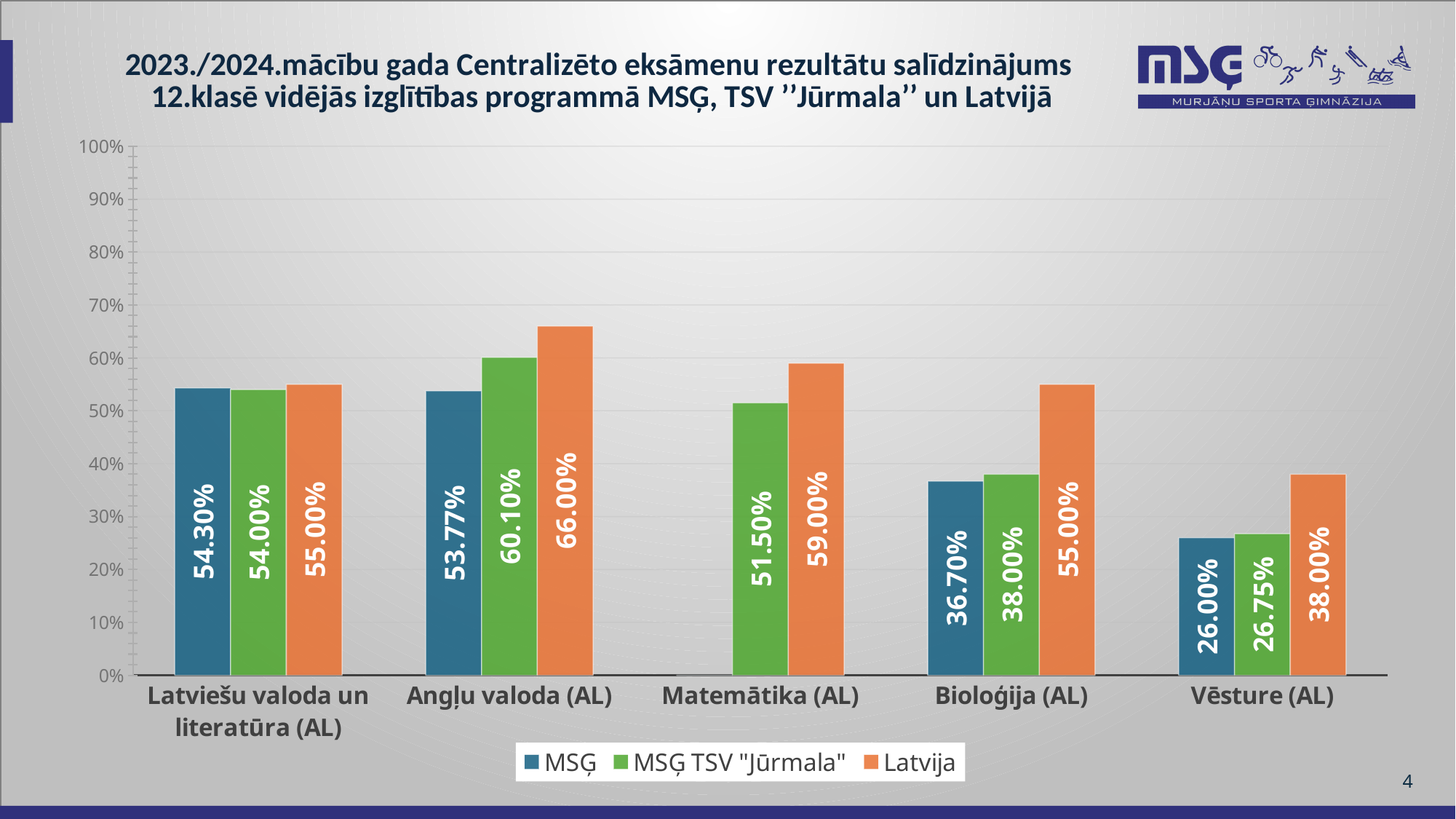
How many series does the legend list? 3 What is the MSĢ TSV "Jūrmala" value for Matemātika (AL)? 51.50% Which series is shown in orange in the legend? Latvija Is the Latvija value for Matemātika (AL) greater or less than 50%? greater Which subject has the highest Latvija value? Angļu valoda (AL) What is the Latvija value for Angļu valoda (AL)? 66.00% How many subjects are shown on the x axis? 5 What kind of chart is shown on the slide? Bar chart What is the MSĢ value for Bioloģija (AL)? 36.70% What is the difference between the Latvija and MSĢ values for Bioloģija (AL)? 18.30% Which is larger for Vēsture (AL): the MSĢ value or the MSĢ TSV "Jūrmala" value? MSĢ TSV "Jūrmala"